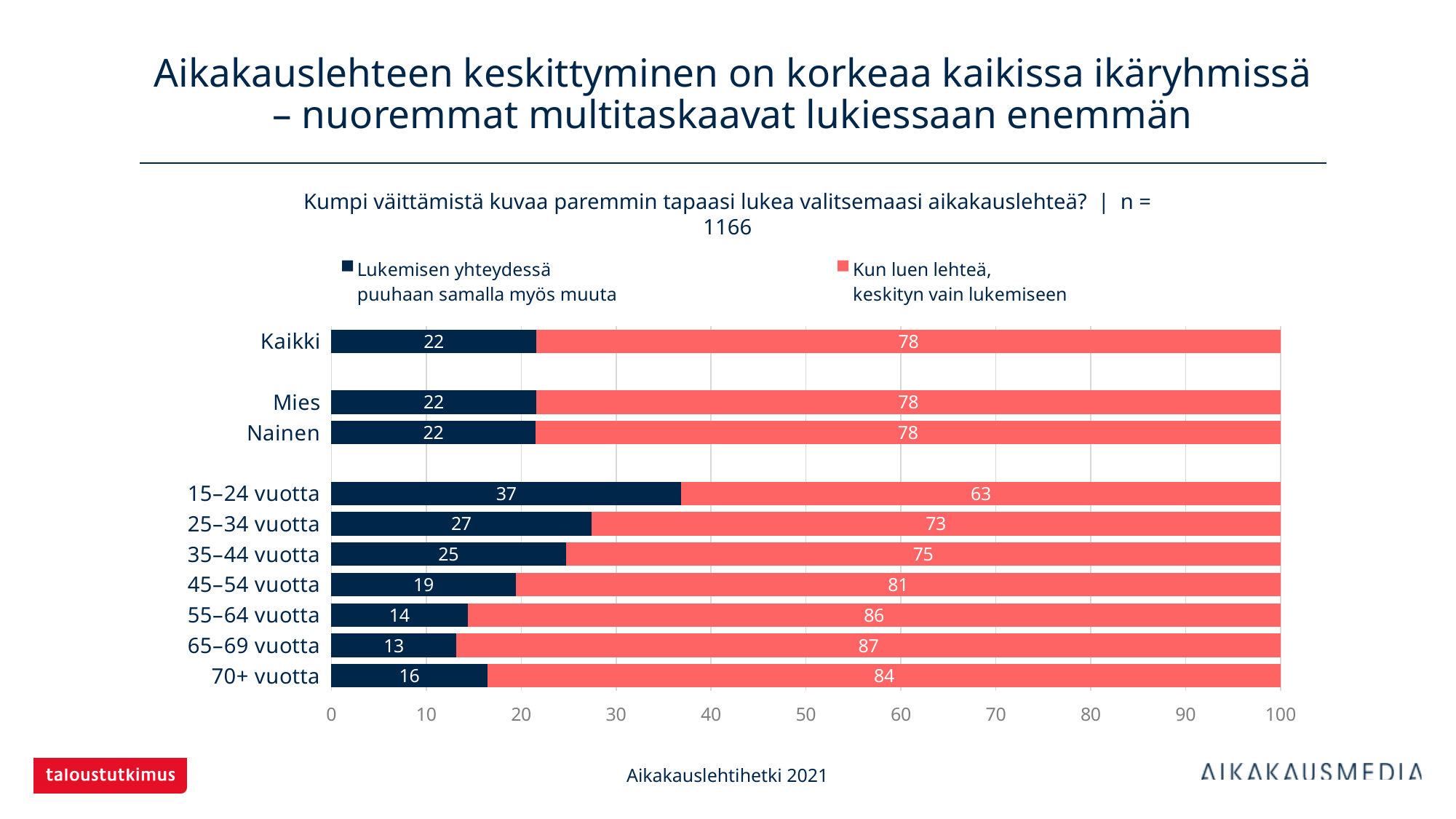
Which category has the highest value for "Lukemisen yhteydessä puuhaan samalla myös muuta"? 15–24 vuotta What is the value of "Lukemisen yhteydessä puuhaan samalla myös muuta" for 15–24 vuotta? 37 What is the difference between the "Lukemisen yhteydessä puuhaan samalla myös muuta" values for 15–24 vuotta and 70+ vuotta? 21 What is the value of "Lukemisen yhteydessä puuhaan samalla myös muuta" for Kaikki? 22 Which category has the highest value for "Kun luen lehteä, keskityn vain lukemiseen"? 65–69 vuotta How many series does the legend list? 2 What is the total of the stacked bar for 35–44 vuotta? 100 How many categories are shown on the y axis of the chart? 10 Which is larger: the "Kun luen lehteä, keskityn vain lukemiseen" value for 25–34 vuotta or for 45–54 vuotta? 45–54 vuotta Which category has the lowest value for "Lukemisen yhteydessä puuhaan samalla myös muuta"? 65–69 vuotta What kind of chart is shown on the slide? Stacked bar chart What is the value of "Kun luen lehteä, keskityn vain lukemiseen" for 55–64 vuotta? 86